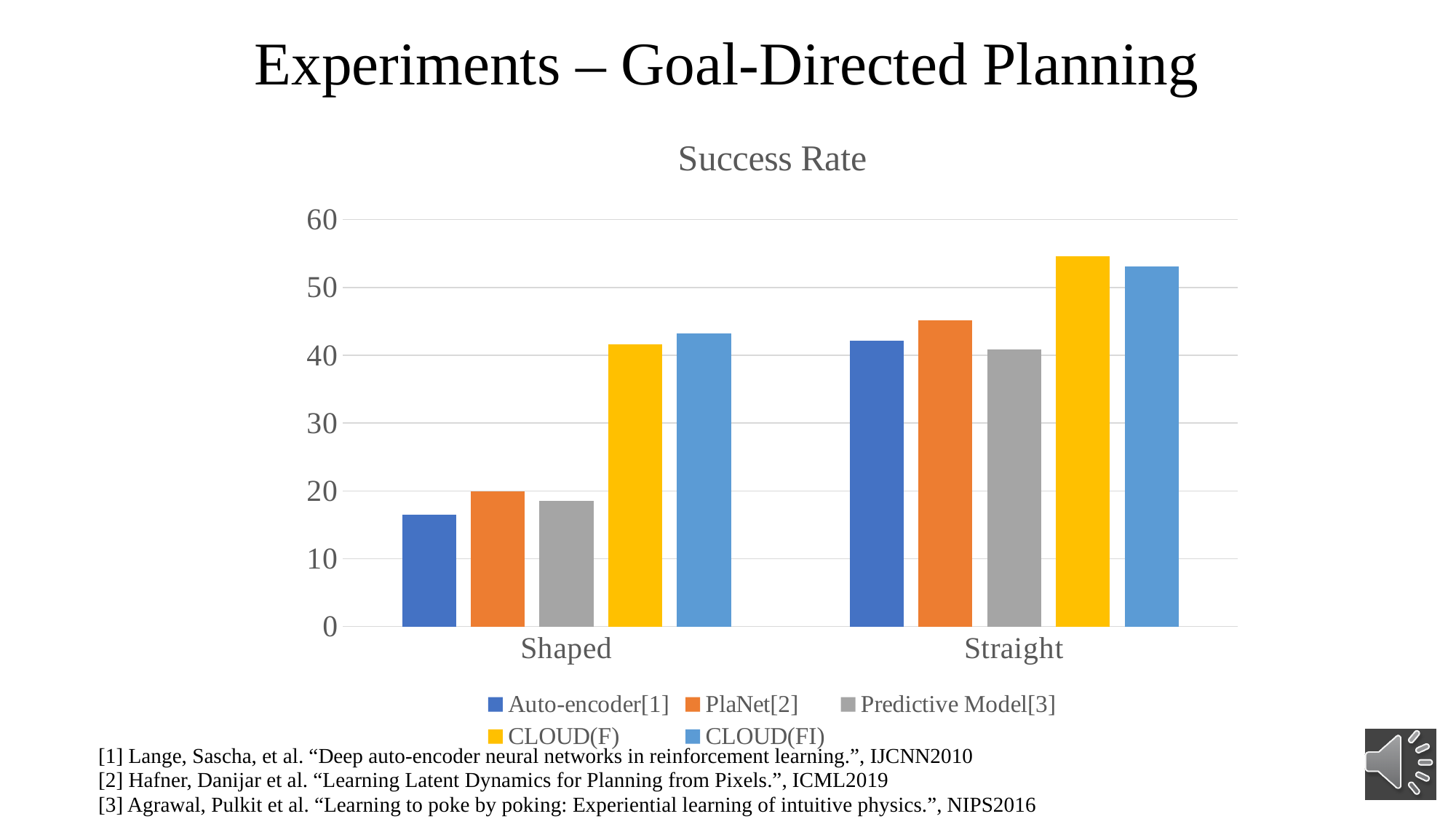
Which series has the highest value for Straight? CLOUD(F) What kind of chart is shown on the slide? bar chart What is the title of the chart? Success Rate Is the value for Auto-encoder[1] in the Shaped category greater or less than 20? less How many series does the legend list? 5 Is the value for PlaNet[2] in the Straight category greater or less than 50? less Which series has the highest value for Shaped? CLOUD(FI) Is the value for CLOUD(FI) in the Straight category greater or less than 50? greater Which is larger for PlaNet[2]: the Shaped value or the Straight value? Straight How many categories are shown on the x axis? 2 Which series has the lowest value for Shaped? Auto-encoder[1]